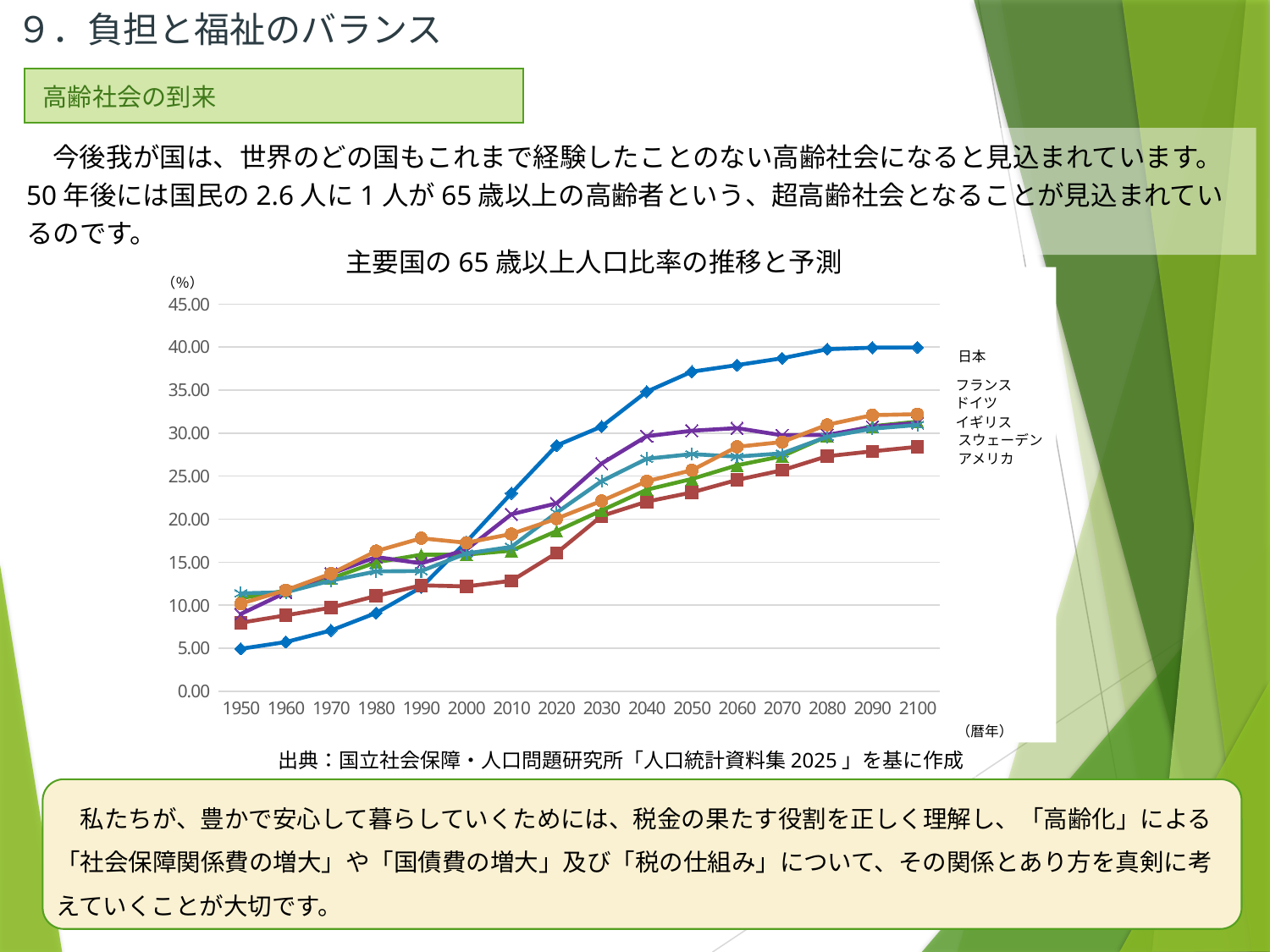
Is the value for アメリカ in 2100 greater or less than 30.00? less Which is larger in 2100, the value for 日本 or the value for アメリカ? 日本 Is the value for 日本 in 2100 greater or less than 35.00? greater Which country has the lowest value in 1950? 日本 How many countries (series) does the chart's legend list? 6 Does the value for 日本 rise or fall from 1950 to 2100? rise What is the title of the chart? 主要国の65歳以上人口比率の推移と予測 What kind of chart is shown on the slide? line chart Which country has the highest value in 2100? 日本 Which country has the lowest value in 2100? アメリカ How many years are marked along the x axis of the chart? 16 Is the value for 日本 in 1950 greater or less than 10.00? less